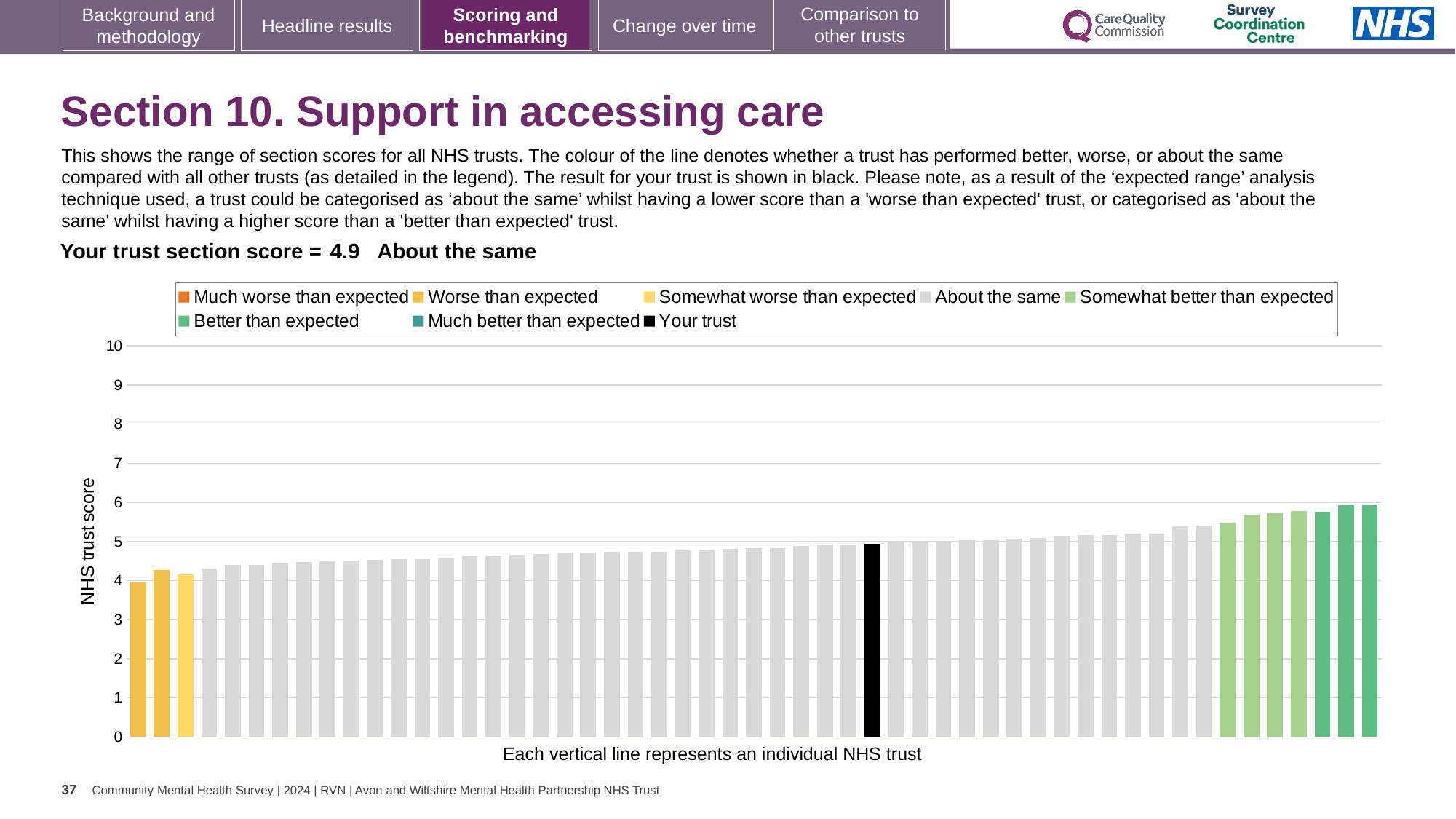
What kind of chart is shown on the slide? bar chart What is the section score for your trust shown on the slide? 4.9 Which is larger, the value for your trust or the value of the leftmost bar? your trust Which is larger, the value for your trust or the value of the rightmost bar? the rightmost bar Is the value of the tallest bar greater or less than 5? greater How many entries does the chart legend list? 8 Do the bar values rise or fall from left to right along the x axis? rise Is the value of the leftmost bar greater or less than 5? less What is the label on the vertical axis of the chart? NHS trust score Is the value for your trust greater or less than 4? greater How is your trust's section score categorised compared with other trusts? About the same What colour is the bar representing your trust? black